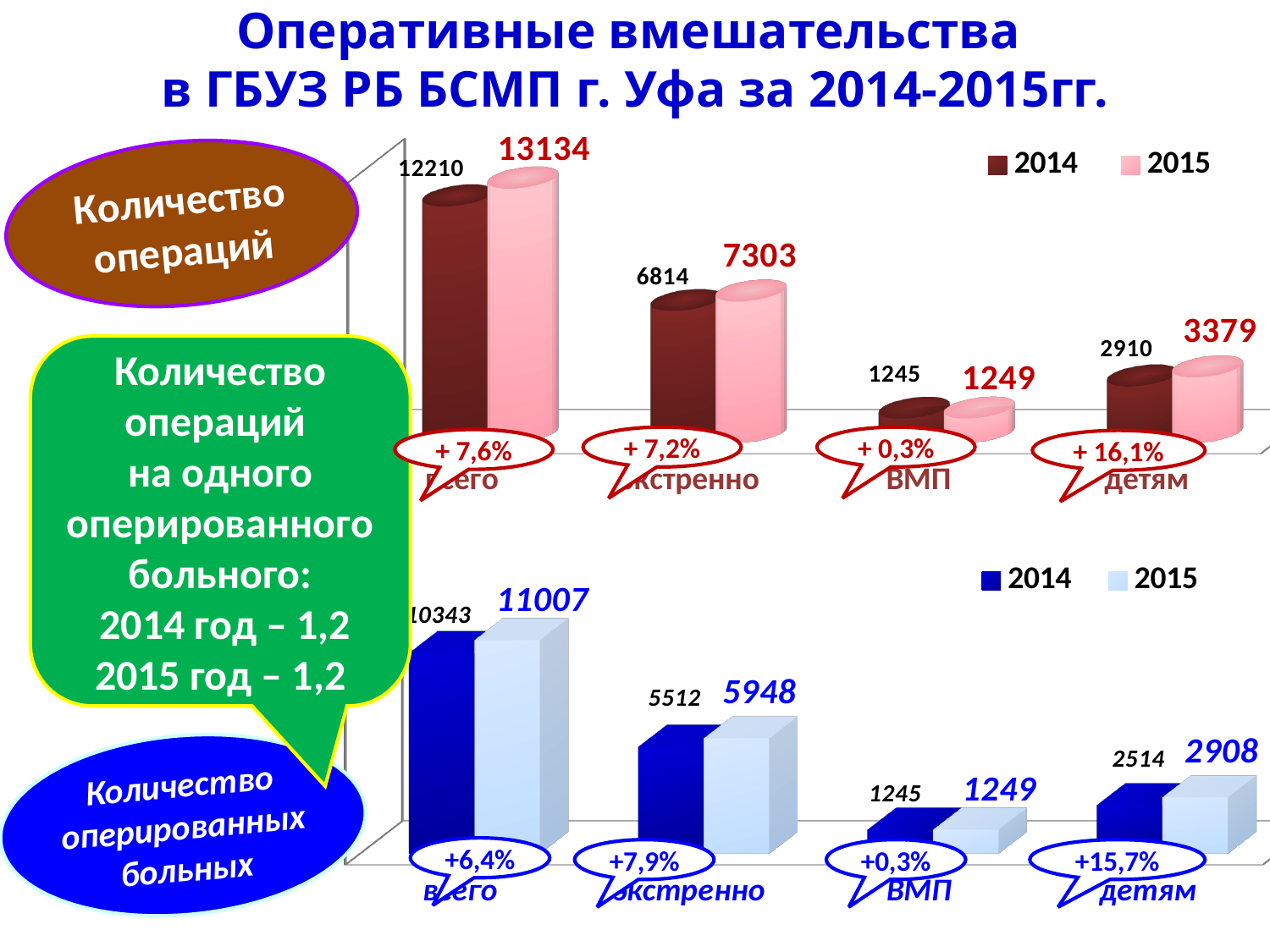
In the top chart (Количество операций), which category has the lowest value for 2014? ВМП What type of chart is the bottom chart (Количество оперированных больных)? Bar chart How many categories are shown on the x axis of the bottom chart (Количество оперированных больных)? 4 In the top chart (Количество операций), what is the difference between the 2015 and 2014 values for 'детям'? 469 In the bottom chart (Количество оперированных больных), what is the value for 2014 in the 'всего' category? 10343 In the bottom chart (Количество оперированных больных), what is the difference between the 2015 and 2014 values for 'экстренно'? 436 In the top chart (Количество операций), which is larger for 'ВМП': the 2014 value or the 2015 value? 2015 In the top chart (Количество операций), what is the value for 2015 in the 'всего' category? 13134 How many series does the legend of the top chart (Количество операций) list? 2 In the bottom chart (Количество оперированных больных), which category has the highest value for 2015? всего In the top chart (Количество операций), what is the value for 2014 in the 'экстренно' category? 6814 In the bottom chart (Количество оперированных больных), what is the value for 2015 in the 'детям' category? 2908